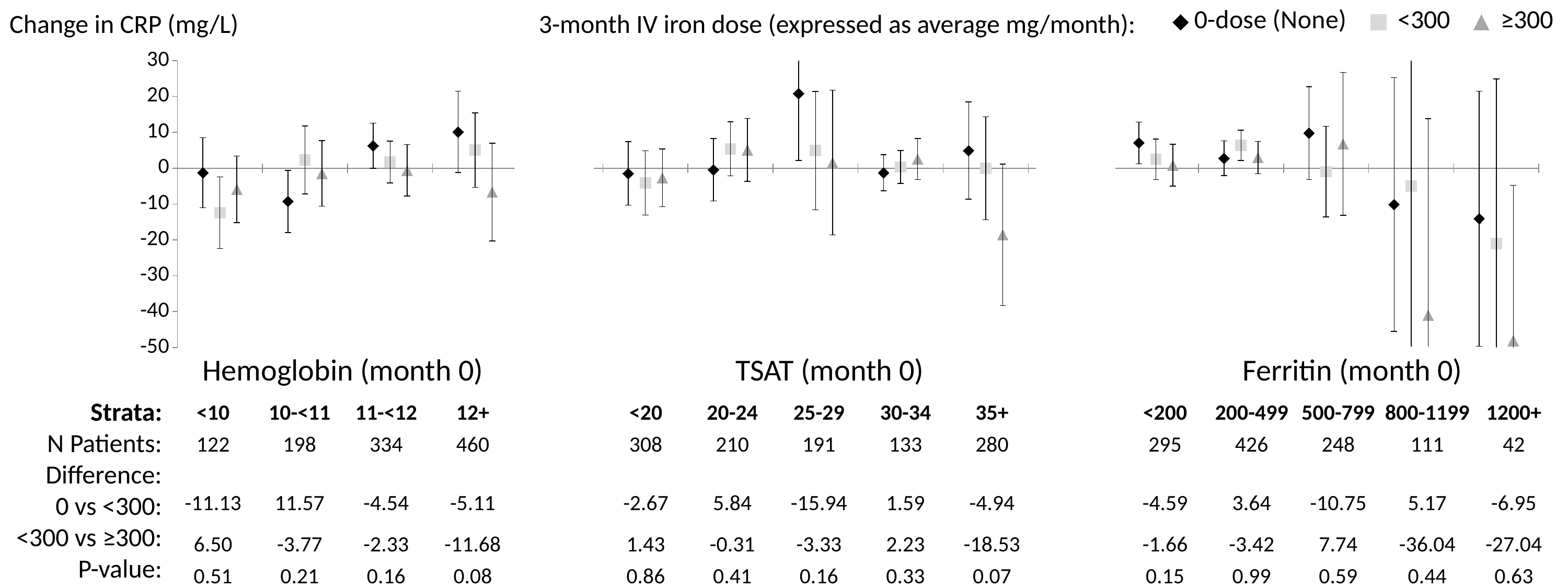
In the TSAT (month 0) panel, is the 0-dose (None) value for the 25-29 stratum greater or less than 10? greater In the Ferritin (month 0) panel, is the ≥300 value for the 1200+ stratum greater or less than -40? less In the TSAT (month 0) panel, how many strata are plotted? 5 In the TSAT (month 0) panel, is the ≥300 value for the 35+ stratum greater or less than -10? less In the TSAT (month 0) panel, which stratum has the highest 0-dose (None) value? 25-29 How many series does the legend list? 3 In the Hemoglobin (month 0) panel, how many strata are plotted? 4 In the TSAT (month 0) panel, what is the P-value for the 35+ stratum? 0.07 What kind of chart is shown on the slide? scatter chart with error bars In the Hemoglobin (month 0) panel, how many patients are in the 12+ stratum? 460 In the Ferritin (month 0) panel, which stratum has the lowest ≥300 value? 1200+ What is the label of the y axis? Change in CRP (mg/L)